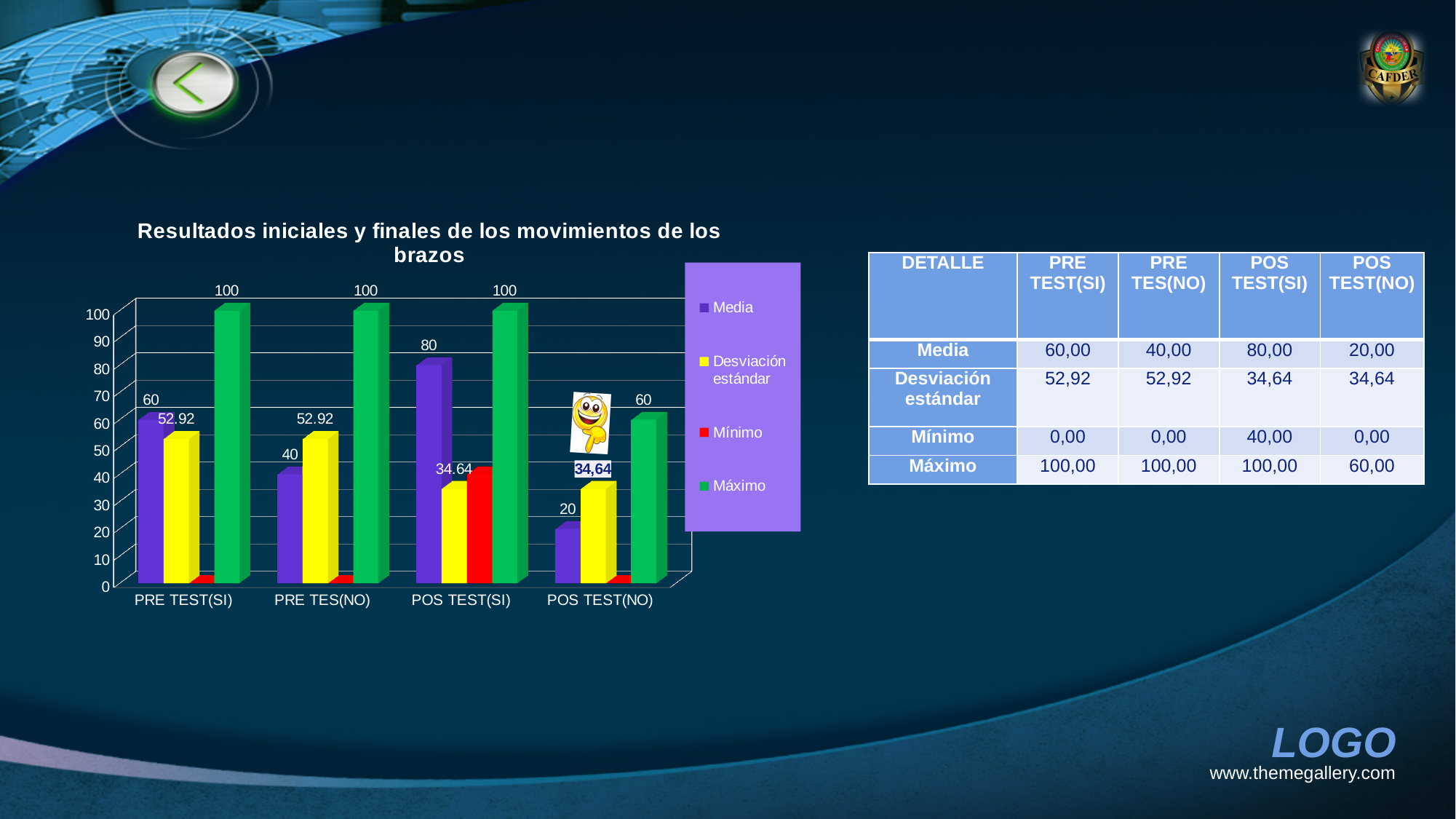
Which category has the lowest Media value? POS TEST(NO) What type of chart is shown on the slide? bar chart What is the Media value for POS TEST(SI)? 80 How many categories are shown on the x axis of the chart? 4 Is the Mínimo value for POS TEST(SI) greater or less than 30? greater What is the difference between the Media values for POS TEST(SI) and PRE TEST(SI)? 20 Which category has the highest Media value? POS TEST(SI) What is the Máximo value for POS TEST(NO)? 60 What is the title of the chart? Resultados iniciales y finales de los movimientos de los brazos Is the Media value for PRE TEST(SI) or for PRE TES(NO) larger? PRE TEST(SI) What is the Desviación estándar value for PRE TES(NO)? 52.92 How many series does the chart legend list? 4